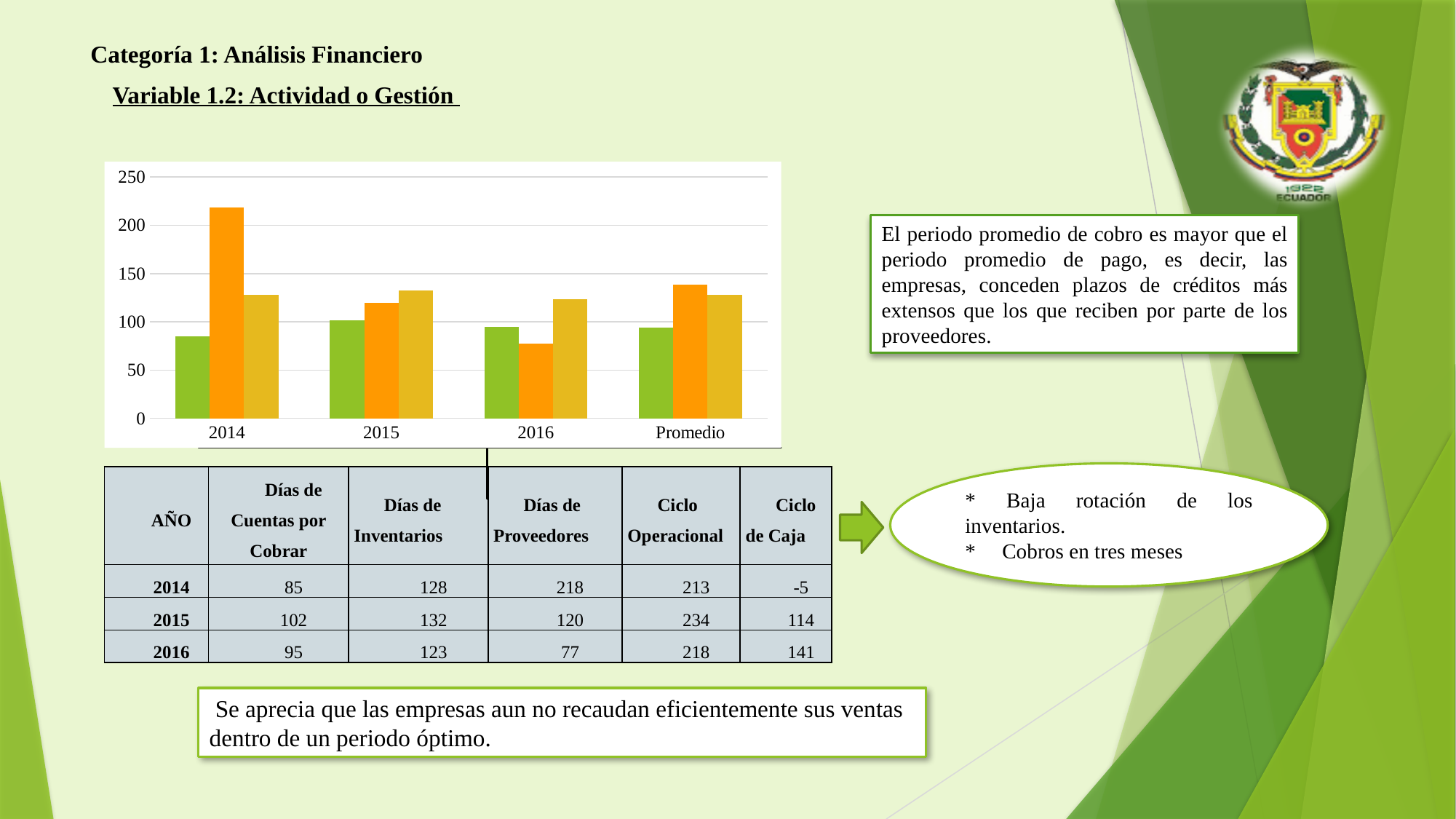
Is the value of the green bar for 2014 greater or less than 100? less Is the value of the yellow bar for Promedio greater or less than 100? greater How many bars are plotted for each category in the chart? 3 How many categories are shown along the x axis of the chart? 4 Which category has the shortest orange bar? 2016 For 2015, which is taller: the orange bar or the yellow bar? the yellow bar Is the value of the orange bar for 2014 greater or less than 200? greater Which category has the tallest orange bar? 2014 What kind of chart is shown on the slide? bar chart For 2016, which is taller: the green bar or the orange bar? the green bar Do the orange bars rise or fall from 2014 to 2016? fall